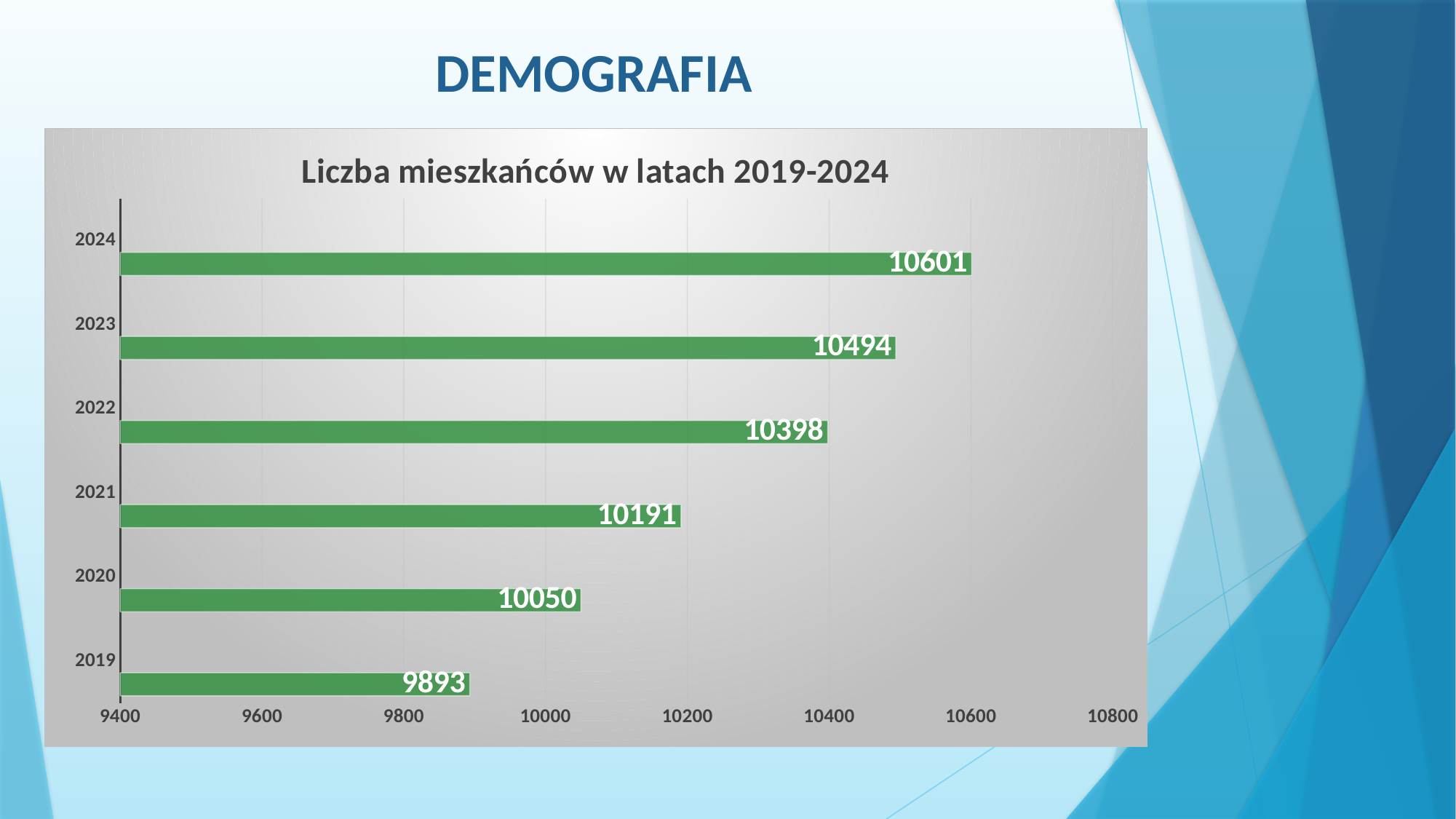
What is the number of residents shown for 2019? 9893 What is the difference between the values for 2020 and 2019? 157 What value is shown for 2021? 10191 Which year has the lowest number of residents? 2019 How many years are shown in the chart? 6 What kind of chart is shown on the slide? bar chart Which is larger, the value for 2022 or the value for 2021? 2022 What is the title of the chart? Liczba mieszkańców w latach 2019-2024 What is the difference between the values for 2024 and 2023? 107 Which year has the highest number of residents? 2024 Is the value for 2023 greater or less than 10400? greater What is the number of residents shown for 2024? 10601